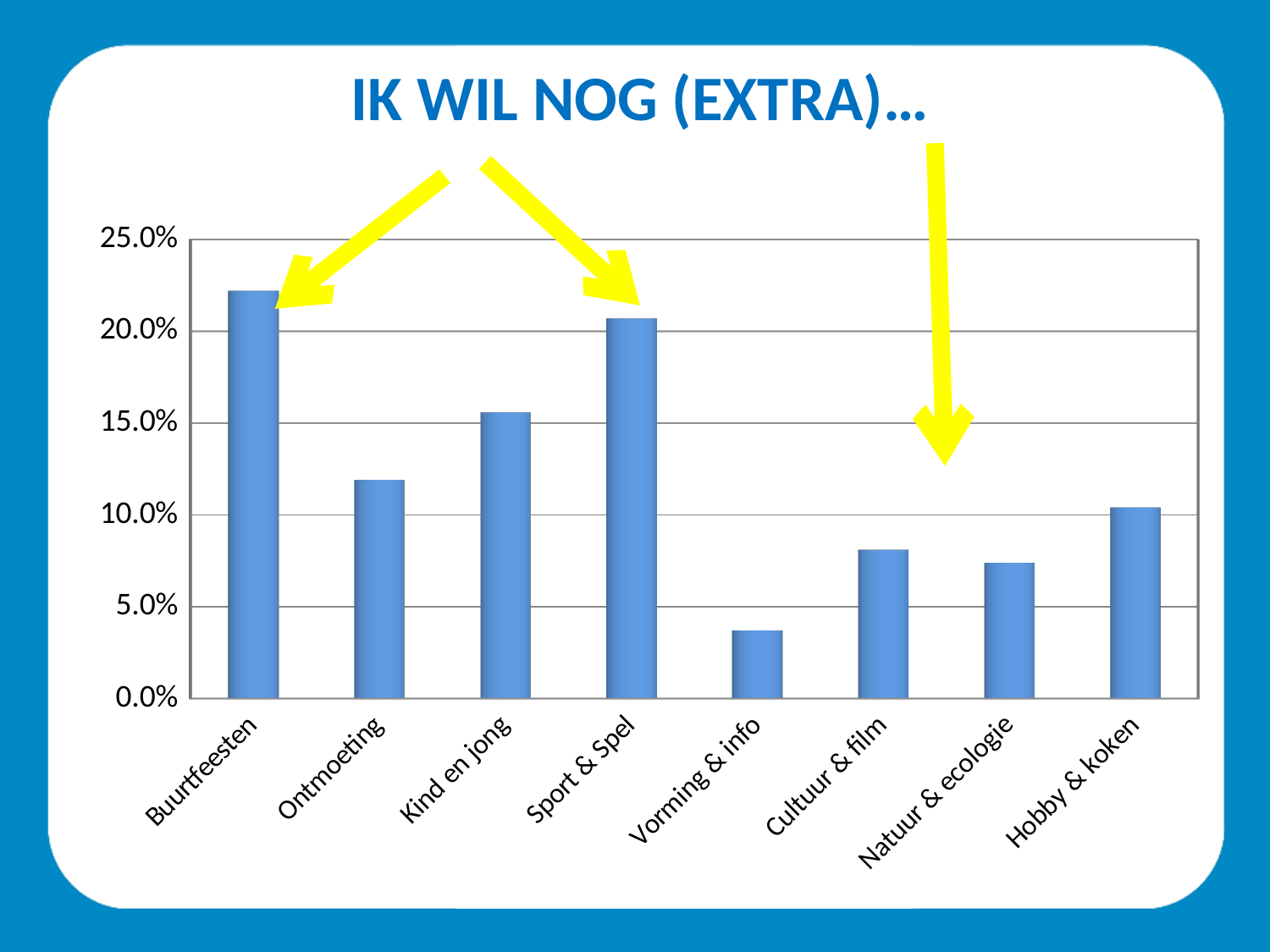
Which category has the highest value in the chart? Buurtfeesten Is the value for Buurtfeesten greater or less than 20.0%? greater Is the value for Ontmoeting greater or less than 10.0%? greater Is the value for Natuur & ecologie greater or less than 10.0%? less How many categories are shown on the x axis of the chart? 8 What kind of chart is shown on the slide? bar chart Which has a larger value, Hobby & koken or Cultuur & film? Hobby & koken Which category has the lowest value in the chart? Vorming & info What is the title of the slide above the chart? IK WIL NOG (EXTRA)… Which has a larger value, Kind en jong or Ontmoeting? Kind en jong